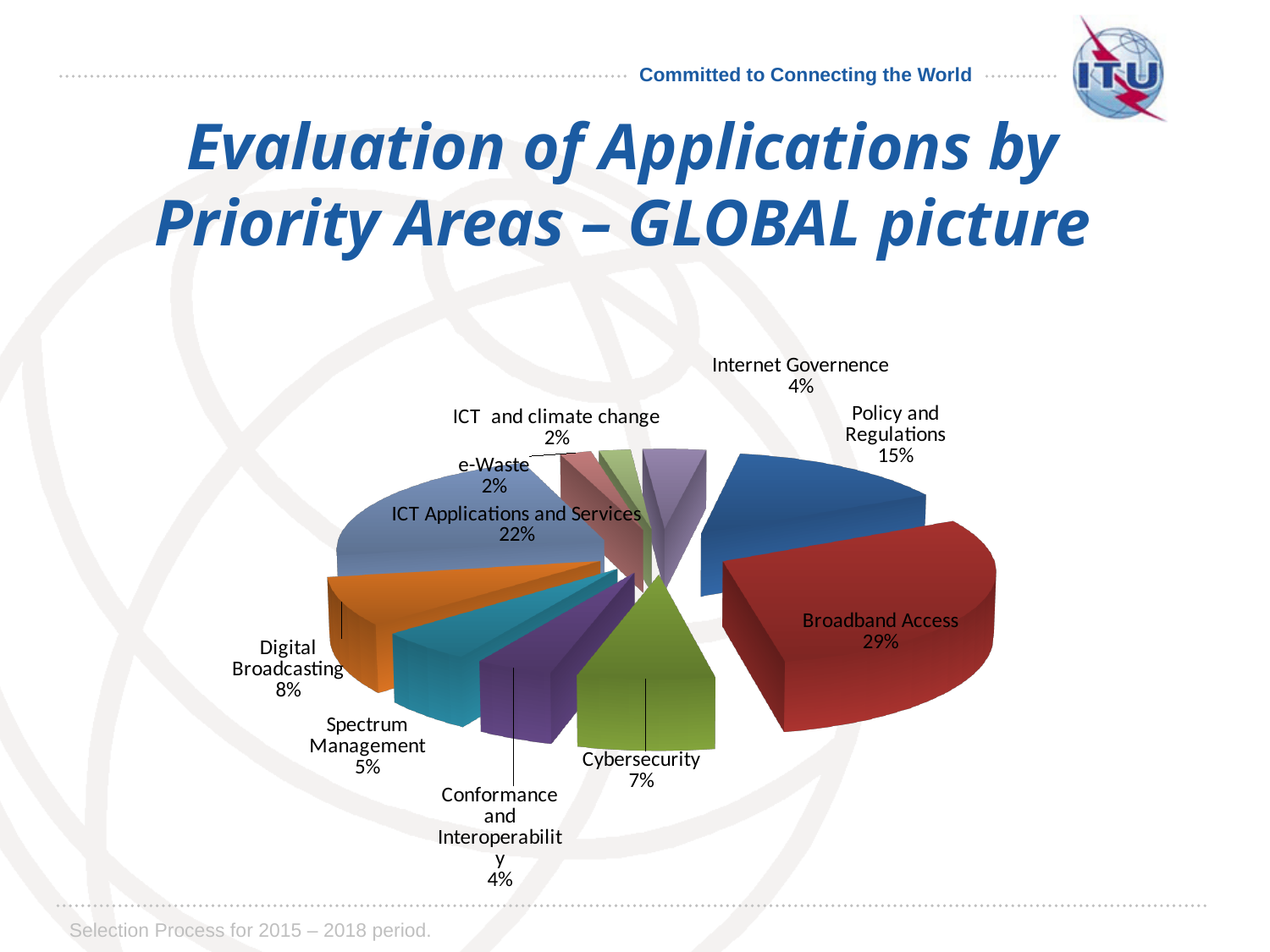
What percentage is shown for Policy and Regulations? 15% What type of chart is shown on the slide? Pie chart Which is larger, the share for Policy and Regulations or the share for Digital Broadcasting? Policy and Regulations What is the value for Digital Broadcasting? 8% What is the title of the slide containing the chart? Evaluation of Applications by Priority Areas – GLOBAL picture Which priority area has the largest share of the pie? Broadband Access What is the value shown for ICT Applications and Services? 22% What share of the pie does Broadband Access represent? 29% What is the difference between the shares of Broadband Access and ICT Applications and Services? 7% How many priority areas (slices) are shown in the pie chart? 10 What is the difference between the shares of Cybersecurity and Spectrum Management? 2% What percentage is shown for Cybersecurity? 7%